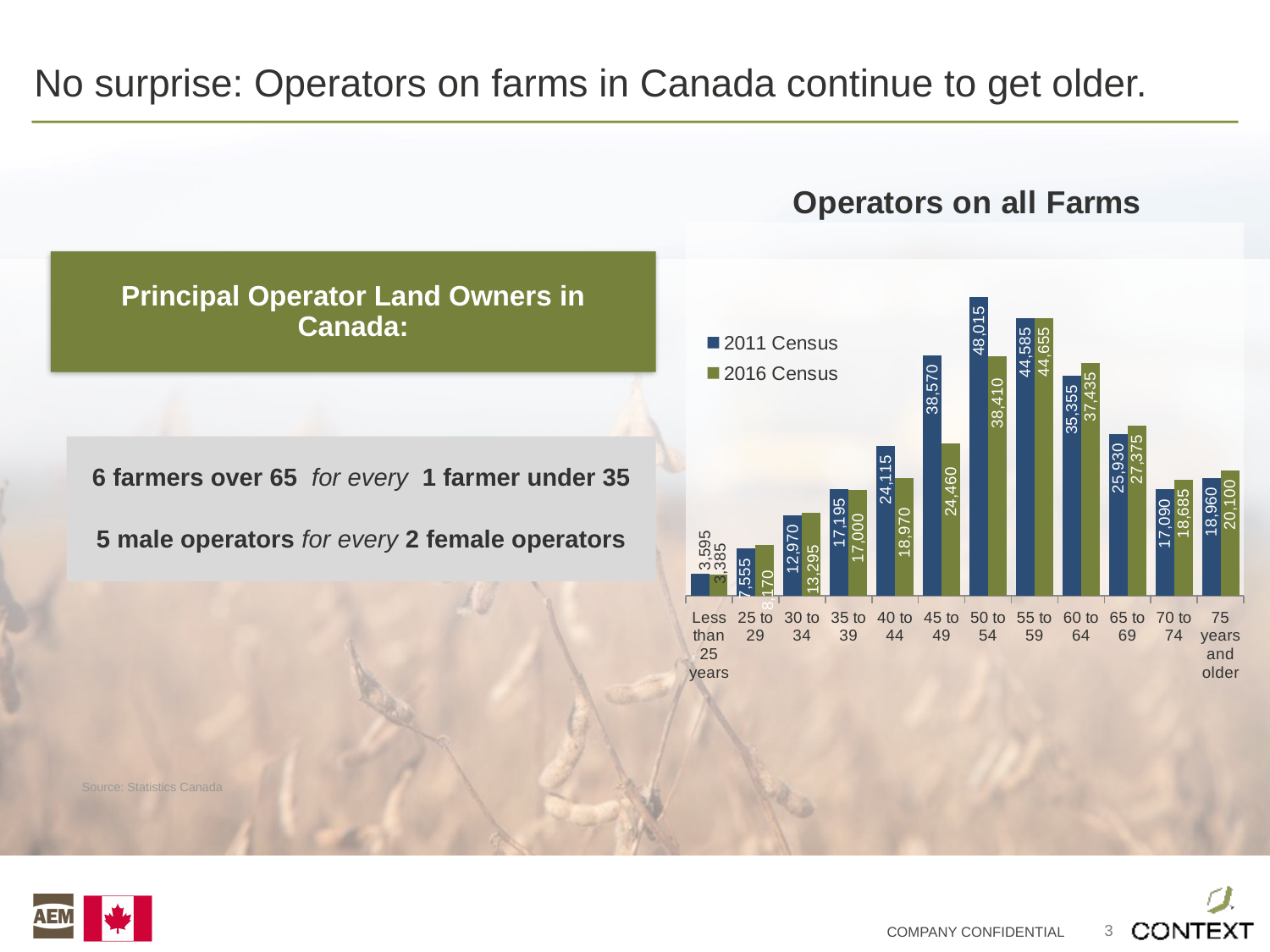
What is the 2011 Census value for operators aged 50 to 54? 48,015 Which age group has the highest number of operators in the 2016 Census? 55 to 59 For the 40 to 44 age group, what is the difference between the 2011 Census and 2016 Census values? 5,145 What is the 2011 Census value for operators aged 35 to 39? 17,195 What is the 2016 Census value for operators aged 60 to 64? 37,435 For operators aged 75 years and older, which census shows the larger value, 2011 or 2016? 2016 Census For the 45 to 49 age group, how much higher is the 2011 Census value than the 2016 Census value? 14,110 What type of chart is used to show operators on all farms? Bar chart How many age groups are shown on the x axis of the chart? 12 Which age group has the highest number of operators in the 2011 Census? 50 to 54 Which age group has the lowest number of operators in the 2016 Census? Less than 25 years How many series does the chart's legend list? 2